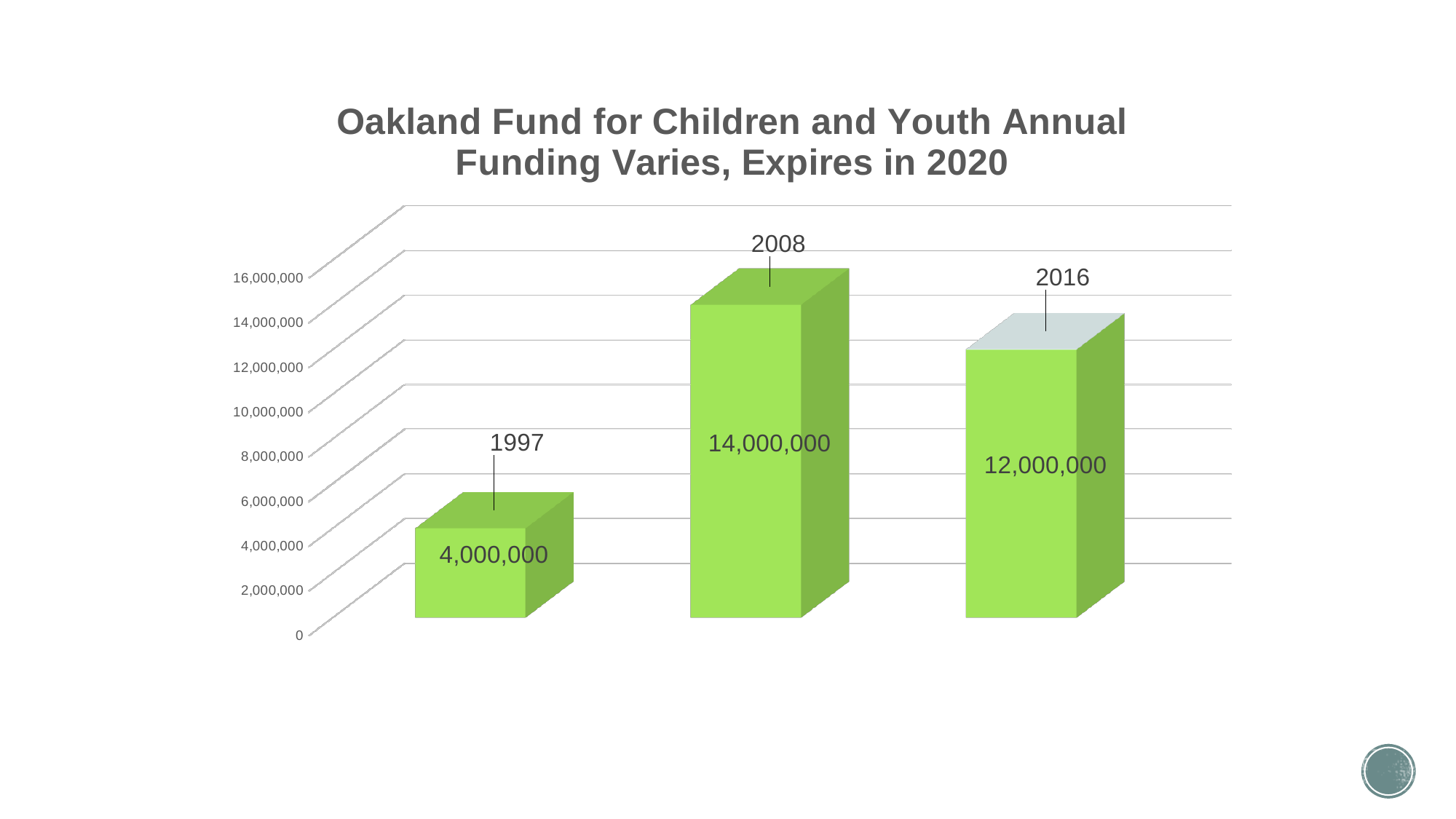
What is the difference between the funding in 2008 and the funding in 1997? 10,000,000 Which year has the lowest annual funding? 1997 What is the annual funding value shown for 2016? 12,000,000 What kind of chart is shown on the slide? Bar chart What is the annual funding value shown for 1997? 4,000,000 Which year has the highest annual funding? 2008 What is the title of the chart? Oakland Fund for Children and Youth Annual Funding Varies, Expires in 2020 Which is larger, the funding for 2016 or the funding for 1997? 2016 What is the annual funding value shown for 2008? 14,000,000 How many years are shown in the chart? 3 What is the difference between the funding in 2008 and the funding in 2016? 2,000,000 Does the funding rise or fall from 2008 to 2016? Fall